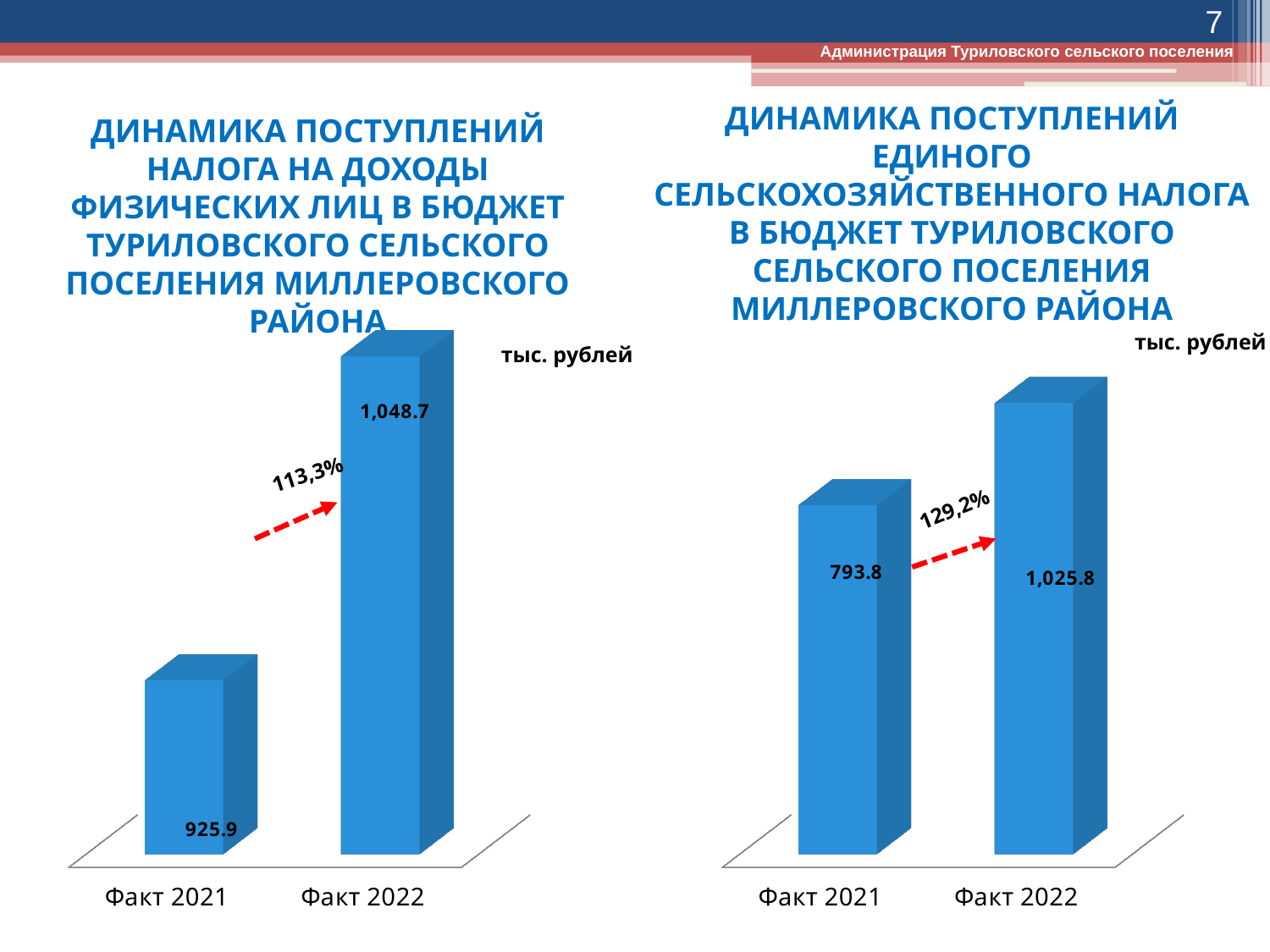
What growth percentage is shown on the arrow in the right chart? 129,2% In the left chart (personal income tax receipts), what is the value for Факт 2022? 1,048.7 In the right chart, what is the difference between the Факт 2022 and Факт 2021 values? 232.0 In the left chart, what is the difference between the Факт 2022 and Факт 2021 values? 122.8 In the right chart, which category has the lower value? Факт 2021 In the right chart (unified agricultural tax receipts), what is the value for Факт 2022? 1,025.8 How many categories are shown in the left chart? 2 In the right chart (unified agricultural tax receipts), what is the value for Факт 2021? 793.8 What type of chart is the right chart? bar chart In the right chart, is the value for Факт 2022 larger or smaller than the value for Факт 2021? larger In the left chart, which category has the higher value? Факт 2022 In the left chart (personal income tax receipts), what is the value for Факт 2021? 925.9